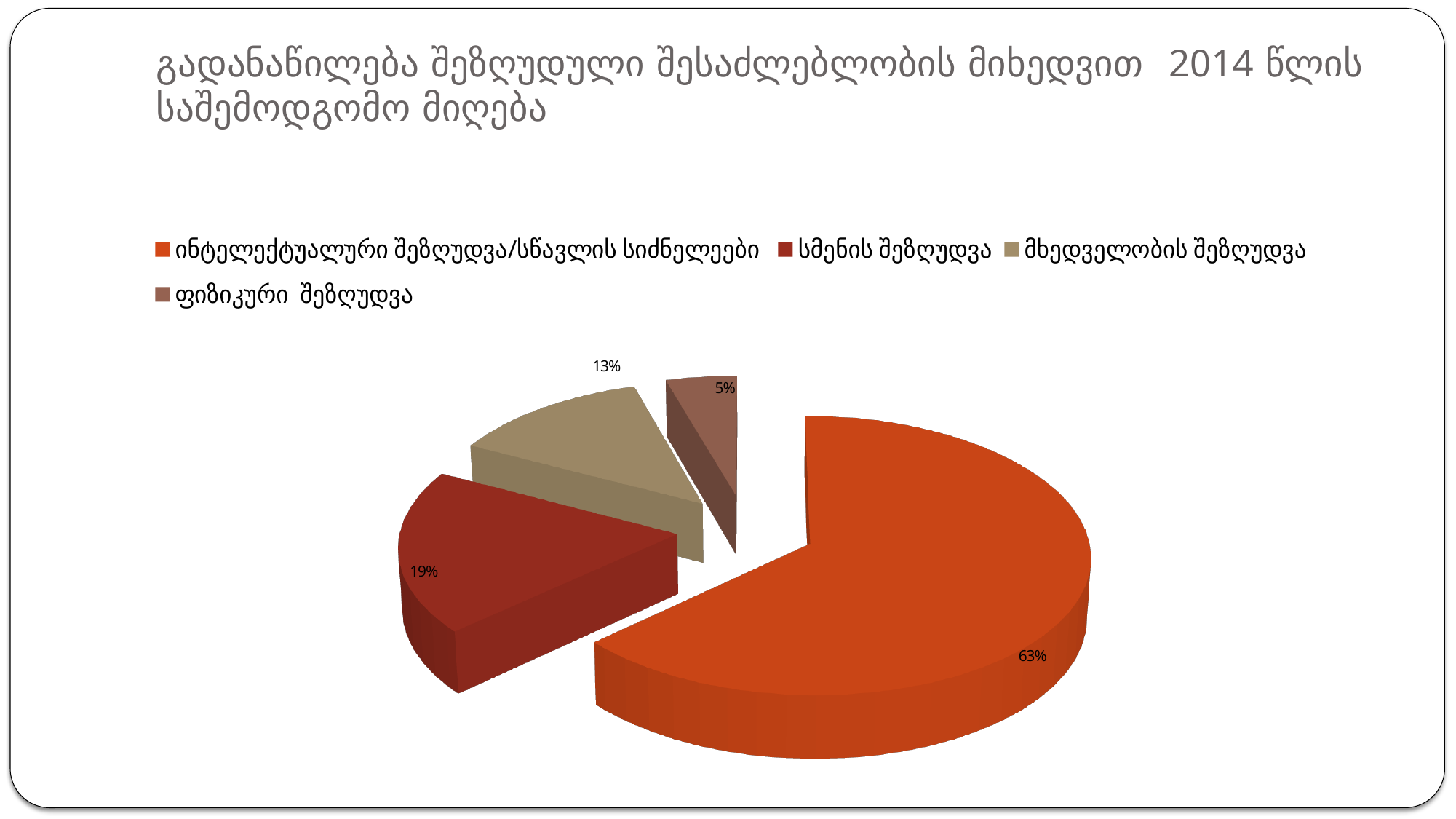
How many entries does the legend list? 4 Which is larger, the slice for სმენის შეზღუდვა or the slice for ფიზიკური შეზღუდვა? სმენის შეზღუდვა What share of the pie does ფიზიკური შეზღუდვა have? 5% What share of the pie does მხედველობის შეზღუდვა have? 13% What colour is the slice for მხედველობის შეზღუდვა? tan Which category has the largest slice of the pie? ინტელექტუალური შეზღუდვა/სწავლის სიძნელეები What share of the pie does სმენის შეზღუდვა have? 19% What is the difference in percentage points between სმენის შეზღუდვა and მხედველობის შეზღუდვა? 6 Which category has the smallest slice of the pie? ფიზიკური შეზღუდვა What share of the pie does ინტელექტუალური შეზღუდვა/სწავლის სიძნელეები have? 63% How many slices does the pie chart have? 4 What kind of chart is shown on the slide? pie chart